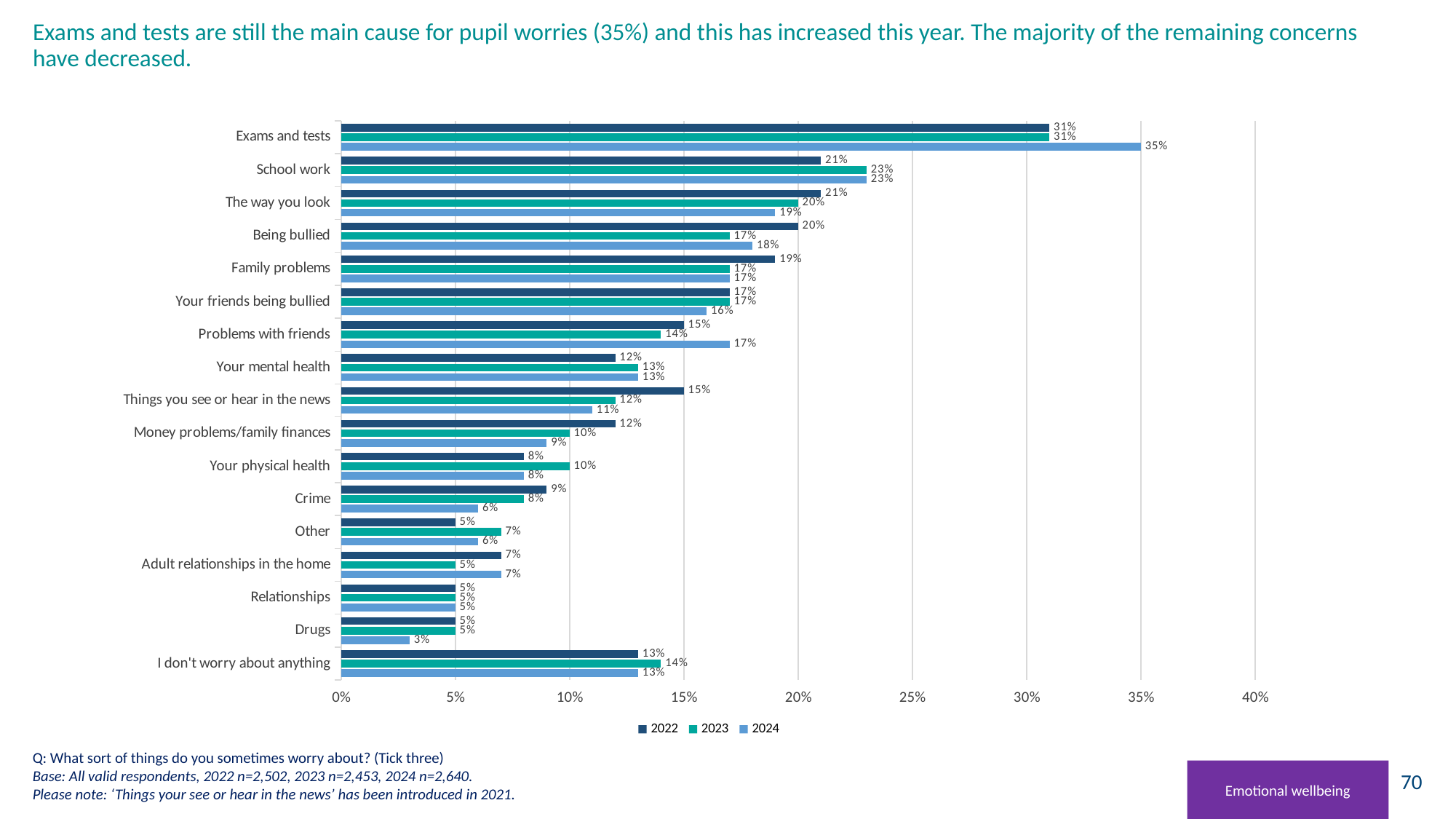
Which category has the lowest 2024 value? Drugs Which is larger for Crime: the 2022 value or the 2024 value? 2022 How many categories are shown on the chart? 17 What is the 2023 value for Your physical health? 10% What is the 2022 value for Being bullied? 20% Which series is shown in the darkest colour in the legend? 2022 Which category has the highest 2024 value? Exams and tests What is the difference between the 2024 and 2022 values for Exams and tests? 4% What is the 2024 value for Exams and tests? 35% What kind of chart is shown on the slide? Bar chart How many series does the legend list? 3 What is the 2024 value for Drugs? 3%